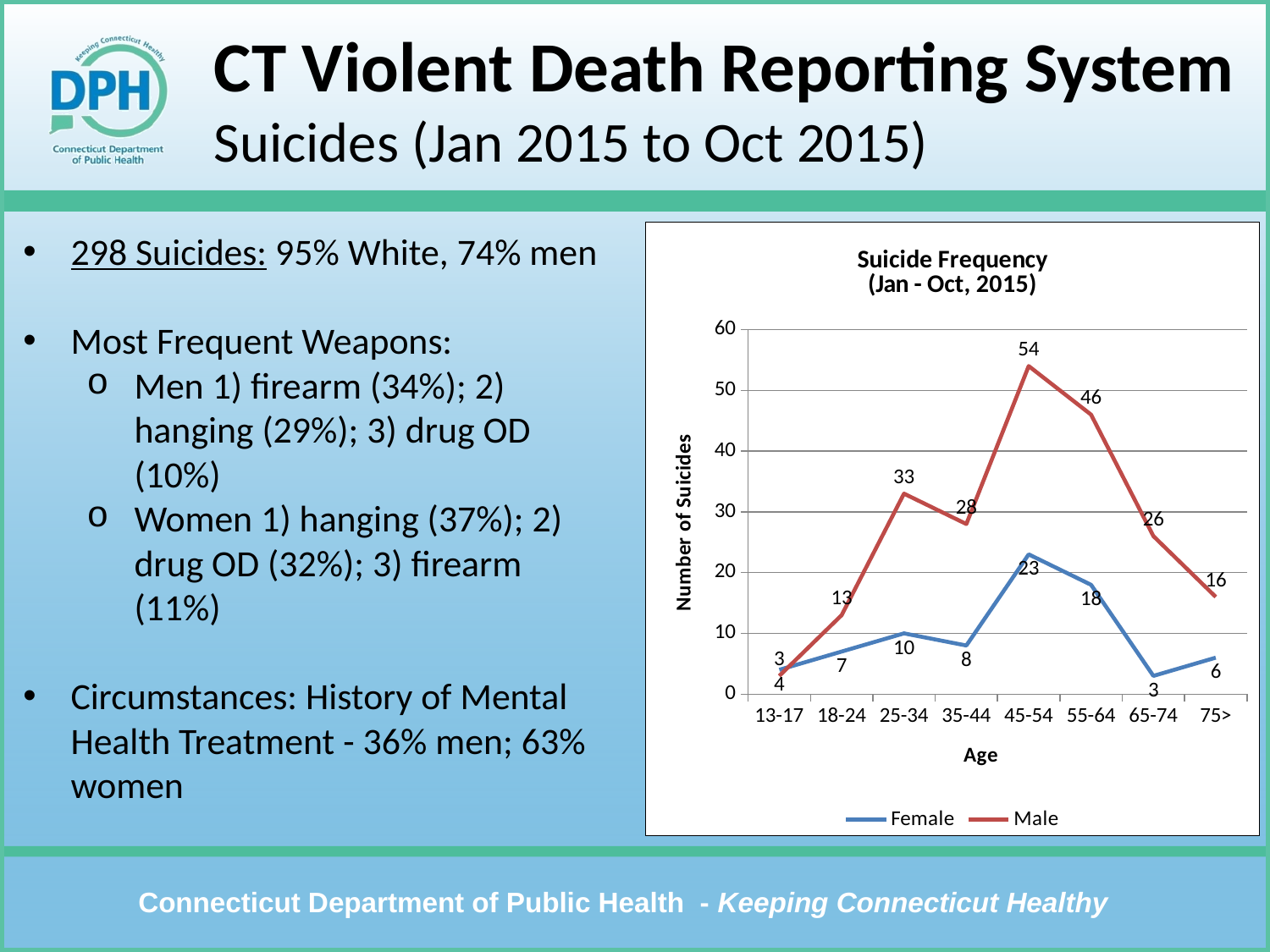
What is the number of female suicides for the 55-64 age group? 18 Which is larger, the number of male suicides for 25-34 or for 35-44? 25-34 Is the number of male suicides for the 55-64 age group greater or less than 40? greater Do male suicides rise or fall from the 45-54 age group to the 75> age group? fall What is the difference between male and female suicides in the 45-54 age group? 31 How many series does the legend list in the Suicide Frequency chart? 2 What is the label of the y axis in the Suicide Frequency chart? Number of Suicides How many age categories are shown on the x axis of the Suicide Frequency chart? 8 What is the number of male suicides for the 45-54 age group? 54 Which age group has the lowest number of female suicides? 65-74 Which age group has the highest number of male suicides? 45-54 What type of chart is shown on the slide? line chart